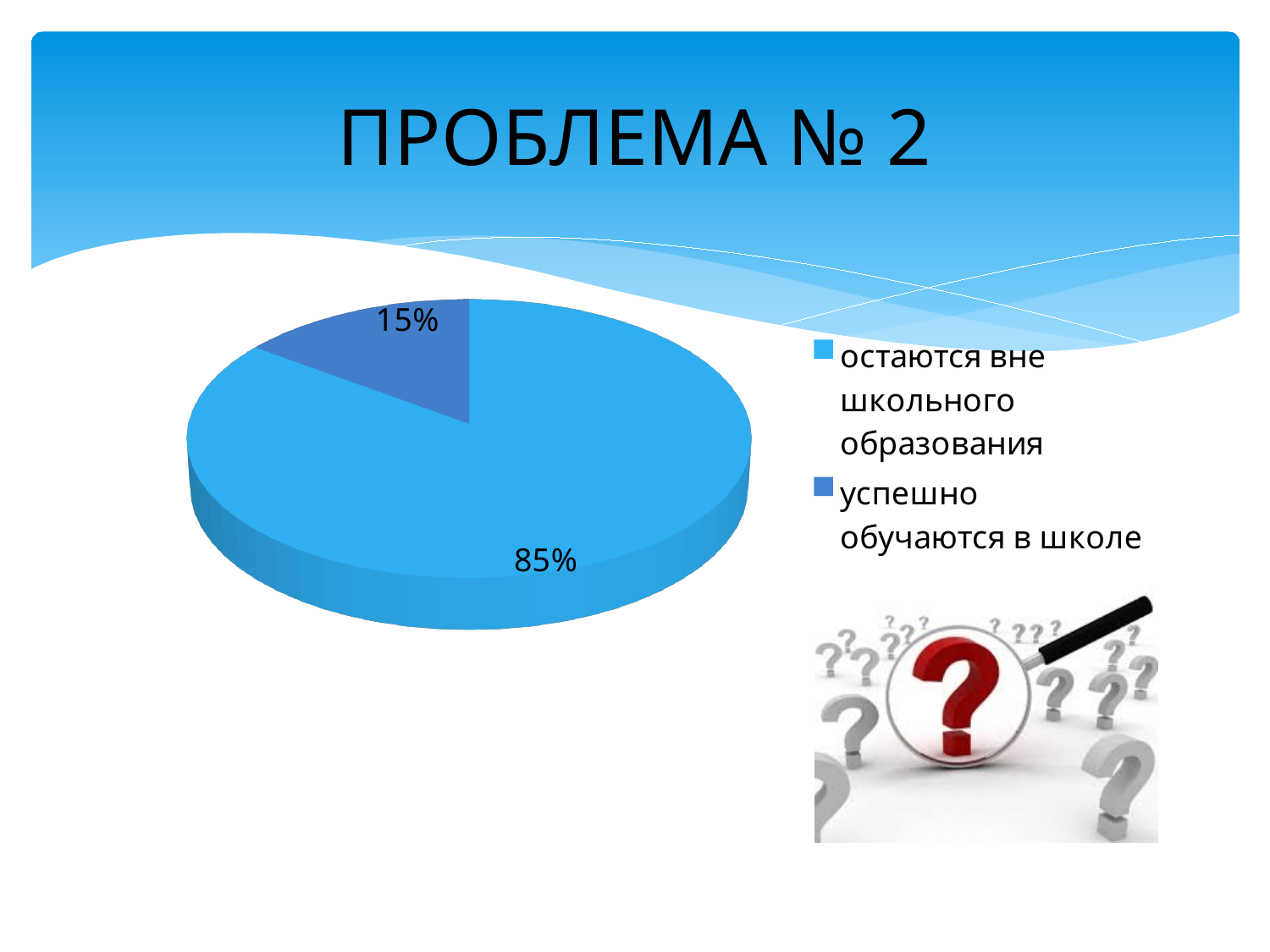
What is the title of the slide containing the pie chart? ПРОБЛЕМА № 2 Which is larger: the slice for "остаются вне школьного образования" or the slice for "успешно обучаются в школе"? остаются вне школьного образования What share of the pie does the "успешно обучаются в школе" slice represent? 15% What percentage of the pie is labelled for "остаются вне школьного образования"? 85% Which legend entry is shown in the darker blue colour? успешно обучаются в школе How many slices does the pie chart have? 2 What percentage of the pie is labelled for "успешно обучаются в школе"? 15% What is the difference in percentage points between the two slices of the pie? 70 How many entries does the legend list? 2 Which category has the smallest slice of the pie? успешно обучаются в школе What kind of chart is shown on the slide? pie chart Which category has the largest slice of the pie? остаются вне школьного образования